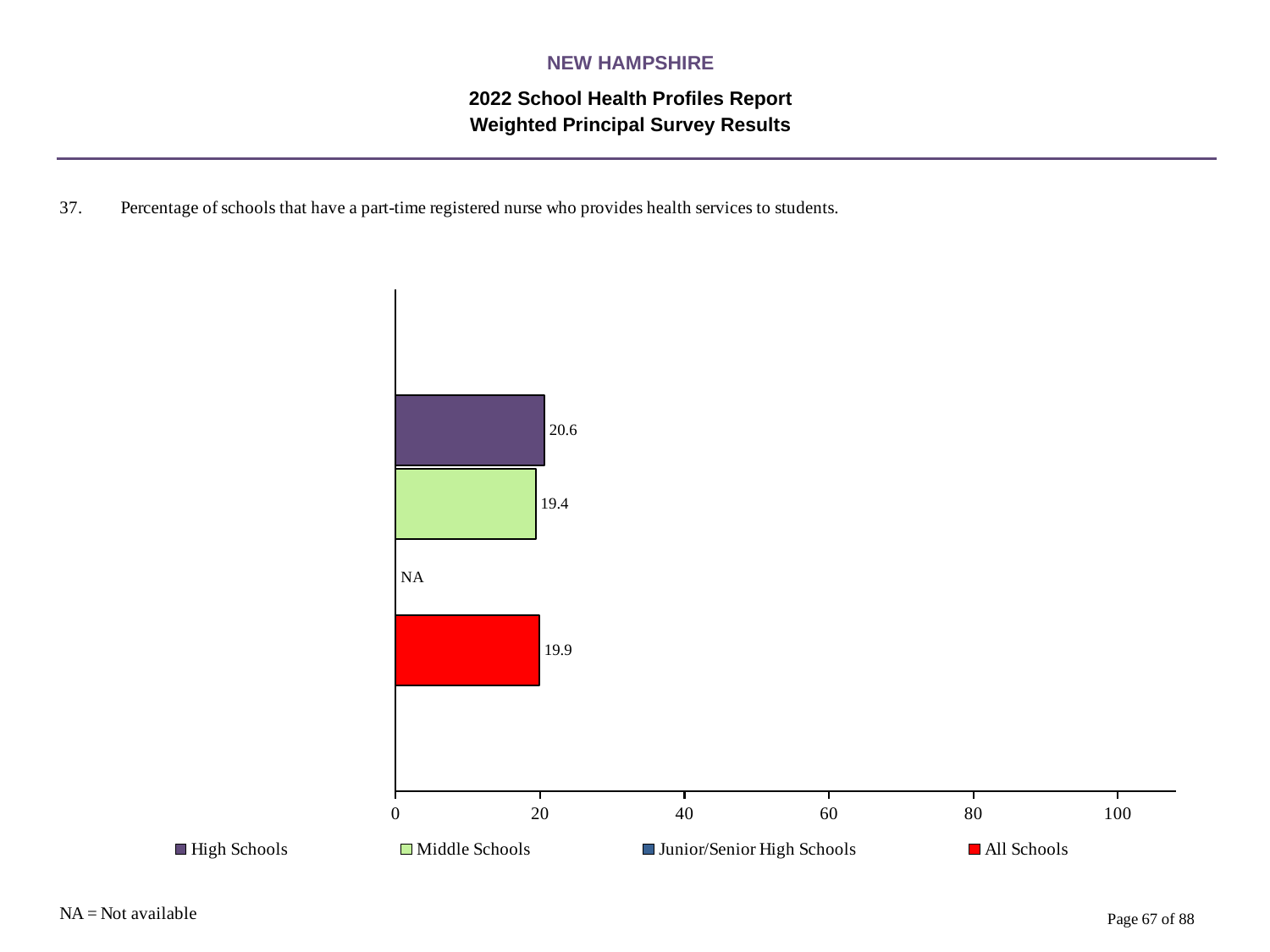
What is shown for Junior/Senior High Schools? NA What is the value for Middle Schools? 19.4 What colour is the All Schools bar? red Which series with a plotted value has the lowest value? Middle Schools What is the difference between the All Schools value and the Middle Schools value? 0.5 How many series does the legend list? 4 What is the value for All Schools? 19.9 Is the value for High Schools greater or less than 40? less What is the value for High Schools? 20.6 Which series has the highest value? High Schools What is the difference between the High Schools value and the Middle Schools value? 1.2 What kind of chart is shown? bar chart